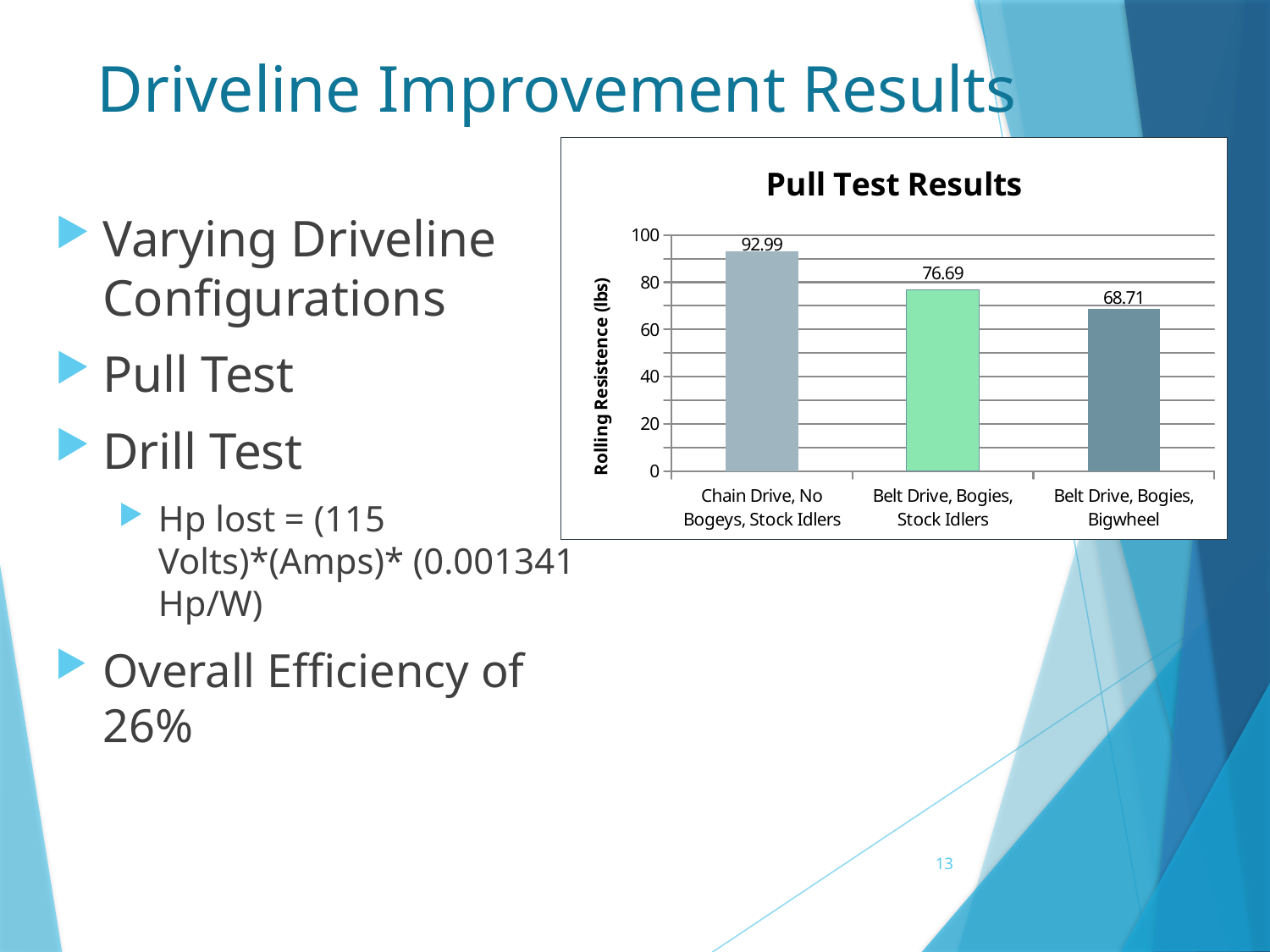
What is the label of the vertical axis of the chart? Rolling Resistence (lbs) What is the difference in rolling resistance between Belt Drive, Bogies, Stock Idlers and Belt Drive, Bogies, Bigwheel? 7.98 What is the rolling resistance value for Belt Drive, Bogies, Stock Idlers? 76.69 How many driveline configurations are shown in the chart? 3 What is the rolling resistance value for Chain Drive, No Bogeys, Stock Idlers? 92.99 Which configuration has the highest rolling resistance? Chain Drive, No Bogeys, Stock Idlers What is the rolling resistance value for Belt Drive, Bogies, Bigwheel? 68.71 What type of chart is used to show the Pull Test Results? bar chart What is the difference in rolling resistance between Chain Drive, No Bogeys, Stock Idlers and Belt Drive, Bogies, Bigwheel? 24.28 Which configuration has the lowest rolling resistance? Belt Drive, Bogies, Bigwheel Which has a larger rolling resistance: Belt Drive, Bogies, Stock Idlers or Belt Drive, Bogies, Bigwheel? Belt Drive, Bogies, Stock Idlers Is the rolling resistance for Belt Drive, Bogies, Bigwheel greater or less than 80? less